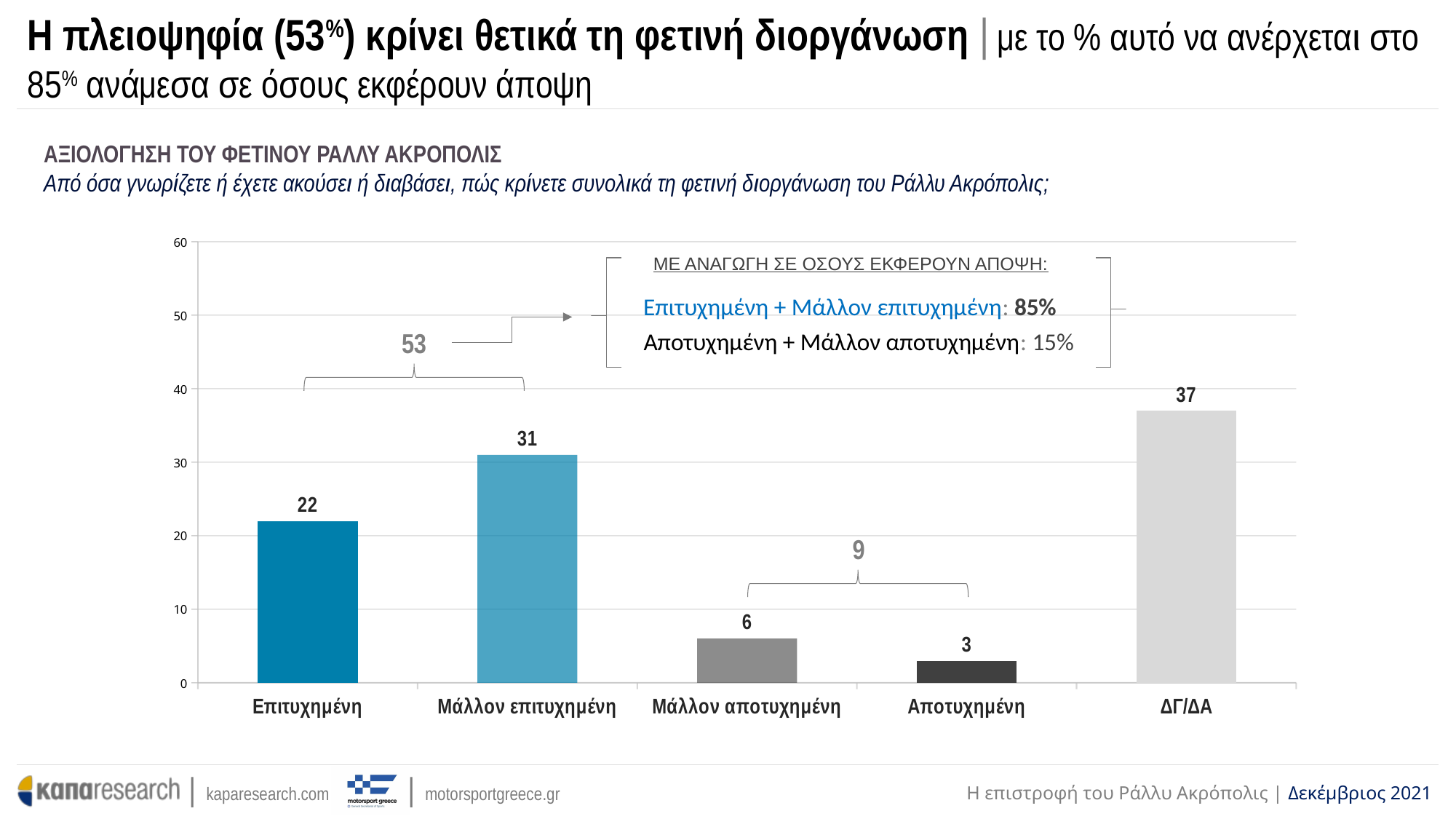
What is the value for Επιτυχημένη? 22 What kind of chart is shown on the slide? bar chart What combined value is shown by the bracket over Επιτυχημένη and Μάλλον επιτυχημένη? 53 Which is larger, the value for Επιτυχημένη or the value for Μάλλον αποτυχημένη? Επιτυχημένη Which category has the highest value? ΔΓ/ΔΑ According to the annotation box, what is the combined share of Επιτυχημένη + Μάλλον επιτυχημένη among those expressing an opinion? 85% What is the value for Μάλλον αποτυχημένη? 6 Which category has the lowest value? Αποτυχημένη What is the value for Μάλλον επιτυχημένη? 31 What is the value for ΔΓ/ΔΑ? 37 How many categories are shown on the x axis? 5 What is the difference between the values for Μάλλον επιτυχημένη and Επιτυχημένη? 9